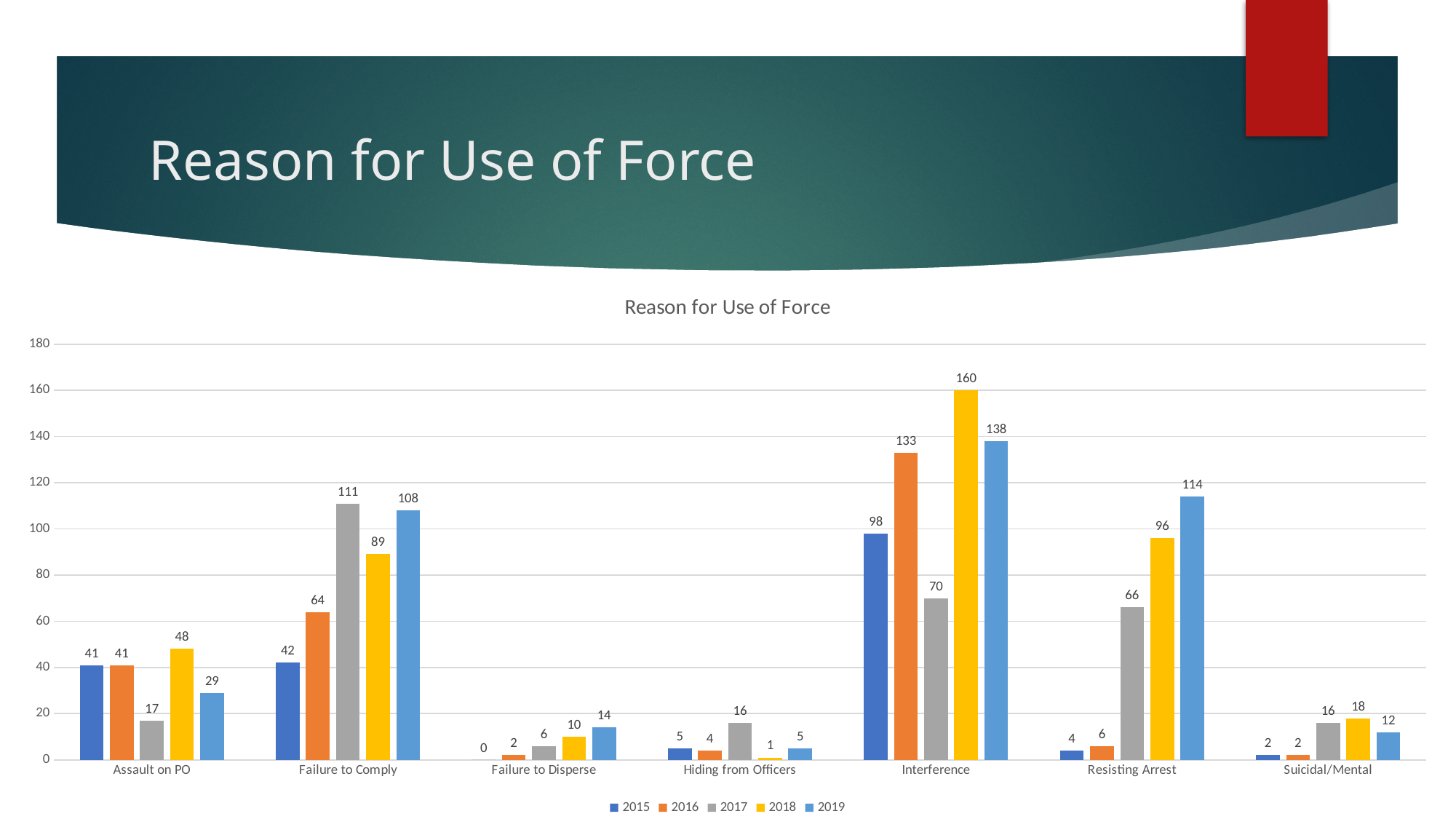
How many series does the legend list? 5 Which category has the highest value in 2016? Interference What is the value for Interference in 2018? 160 What is the difference between the 2017 and 2018 values for Resisting Arrest? 30 How many categories are shown on the x axis? 7 What is the value for Failure to Comply in 2017? 111 What is the title of the chart? Reason for Use of Force What kind of chart is shown on the slide? Bar chart What is the value for Resisting Arrest in 2019? 114 What is the difference between the 2018 and 2019 values for Interference? 22 Which category has the lowest value in 2015? Failure to Disperse Which is larger for Failure to Comply: the 2017 value or the 2019 value? 2017